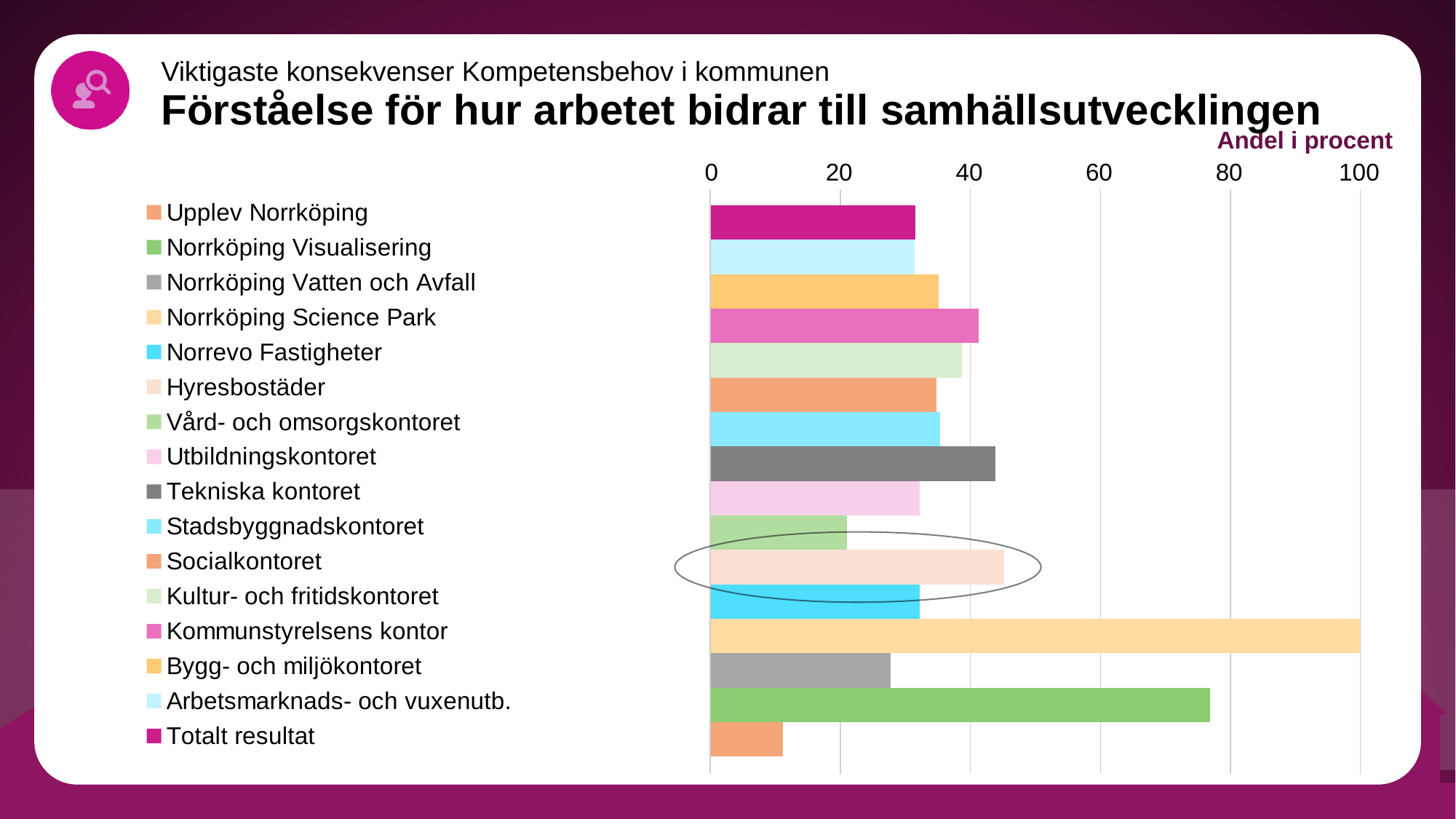
Which series has the lowest value? Upplev Norrköping What unit label is shown above the horizontal axis? Andel i procent How many bars are plotted in the chart? 16 How many series does the legend list? 16 Is the value for Upplev Norrköping greater or less than 20? less Is the value for Norrköping Visualisering greater or less than 60? greater What kind of chart is shown on the slide? bar chart Which series' bar is circled on the chart? Hyresbostäder Is the value for Totalt resultat greater or less than 40? less What is the value for Norrköping Science Park? 100 Which series has the highest value? Norrköping Science Park Which is larger, the value for Norrköping Visualisering or the value for Tekniska kontoret? Norrköping Visualisering